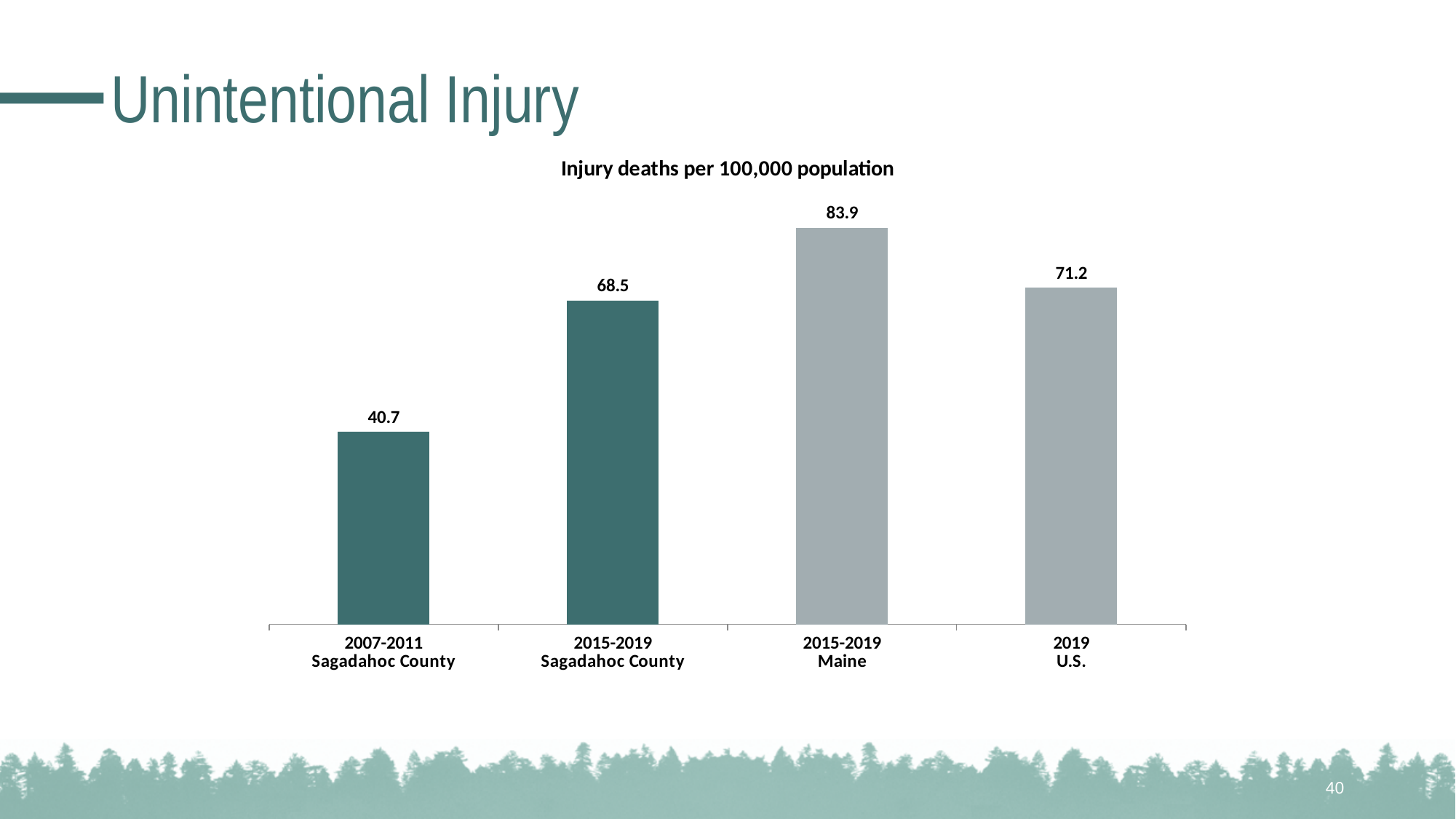
What is the value for 2019 U.S.? 71.2 What is the value for 2015-2019 Sagadahoc County? 68.5 What is the difference between the values for 2015-2019 Sagadahoc County and 2007-2011 Sagadahoc County? 27.8 What is the difference between the values for 2015-2019 Maine and 2019 U.S.? 12.7 Which category has the highest value? 2015-2019 Maine How many bars are shown in the chart? 4 Which is larger, the value for 2015-2019 Maine or the value for 2019 U.S.? 2015-2019 Maine What kind of chart is shown on the slide? Bar chart Which category has the lowest value? 2007-2011 Sagadahoc County What is the value for 2015-2019 Maine? 83.9 What is the value for 2007-2011 Sagadahoc County? 40.7 What is the title of the chart? Injury deaths per 100,000 population